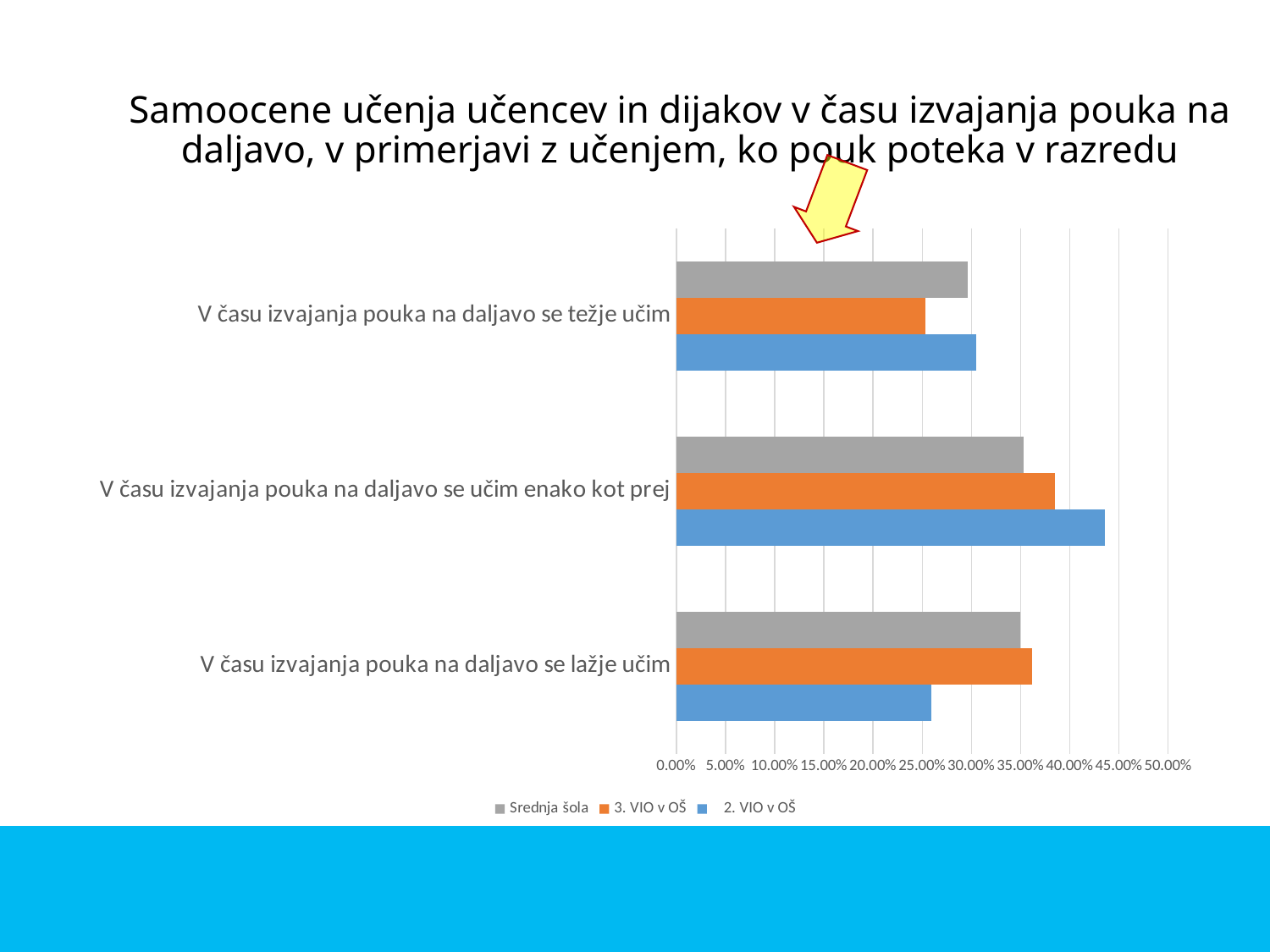
Is the value for 3. VIO v OŠ in the category "V času izvajanja pouka na daljavo se težje učim" greater or less than 30.00%? less For the series 2. VIO v OŠ, which is larger: the value for "V času izvajanja pouka na daljavo se učim enako kot prej" or the value for "V času izvajanja pouka na daljavo se lažje učim"? V času izvajanja pouka na daljavo se učim enako kot prej How many categories are shown on the chart? 3 Which series are listed in the legend? Srednja šola, 3. VIO v OŠ, 2. VIO v OŠ Is the value for 2. VIO v OŠ in the category "V času izvajanja pouka na daljavo se učim enako kot prej" greater or less than 40.00%? greater What colour are the bars for the series 3. VIO v OŠ? orange How many series does the legend list? 3 Is the value for 2. VIO v OŠ in the category "V času izvajanja pouka na daljavo se lažje učim" greater or less than 30.00%? less What kind of chart is shown on the slide? bar chart In the category "V času izvajanja pouka na daljavo se učim enako kot prej", which series has the highest value? 2. VIO v OŠ In the category "V času izvajanja pouka na daljavo se lažje učim", which series has the lowest value? 2. VIO v OŠ